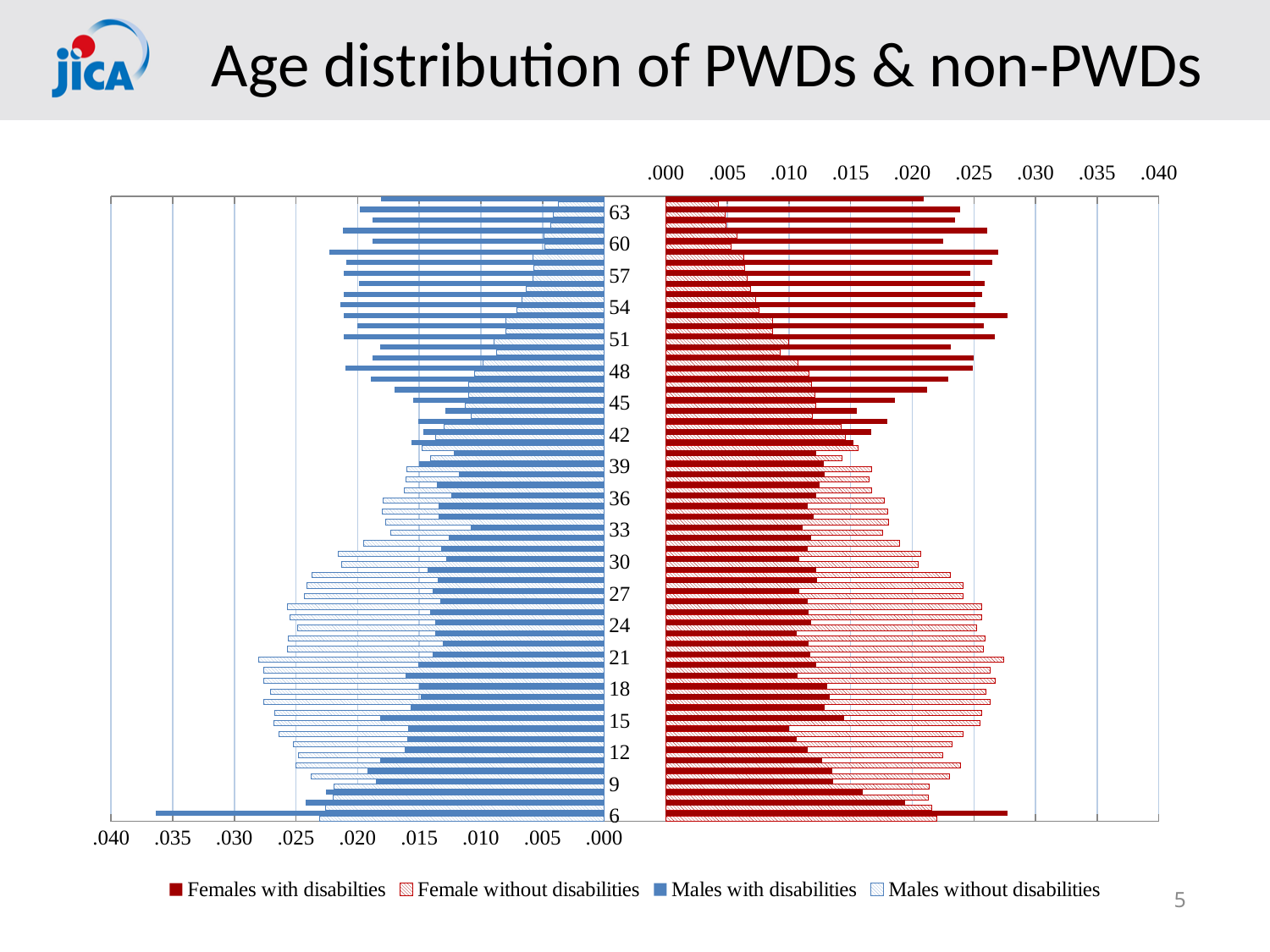
At age 21, which is larger: Males with disabilities or Males without disabilities? Males without disabilities Which series is shown in solid dark red? Females with disabilties What is the title of the chart? Age distribution of PWDs & non-PWDs At which age is the value for Males with disabilities highest? 6 Is the value for Males without disabilities at age 63 greater or less than .005? less Is the value for Female without disabilities at age 63 greater or less than .010? less At age 63, which is larger: Females with disabilties or Female without disabilities? Females with disabilties Is the value for Males with disabilities at age 6 greater or less than .030? greater What kind of chart is shown on the slide? Bar chart How many series does the legend list? 4 Do the values for Female without disabilities generally rise or fall as age increases from 21 to 63? fall